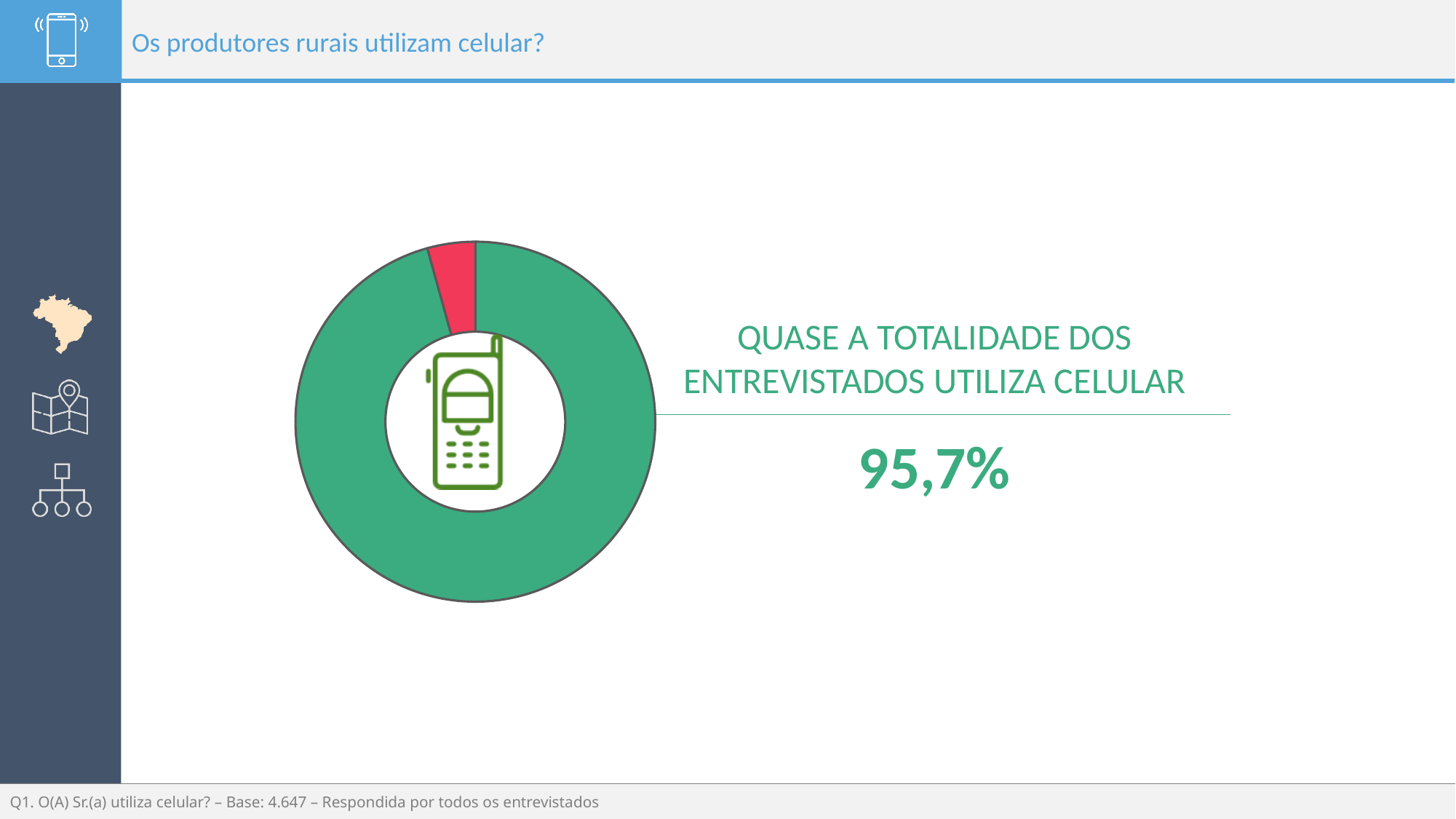
What percentage of respondents use a cell phone, according to the value printed next to the donut chart? 95,7% How many slices does the donut chart have? 2 Which slice of the donut chart is the smallest? The red slice Which slice of the donut chart is larger, the green one or the red one? The green one What is the title of the slide containing the donut chart? Os produtores rurais utilizam celular? What is the base (number of respondents) stated in the footnote for the chart? 4.647 Is the red slice of the donut chart greater or less than 10% of the whole? less What colour is the slice representing respondents who use a cell phone? Green Is the share of respondents who use a cell phone greater or less than 90%? greater What kind of chart is shown on the slide? Donut (pie) chart